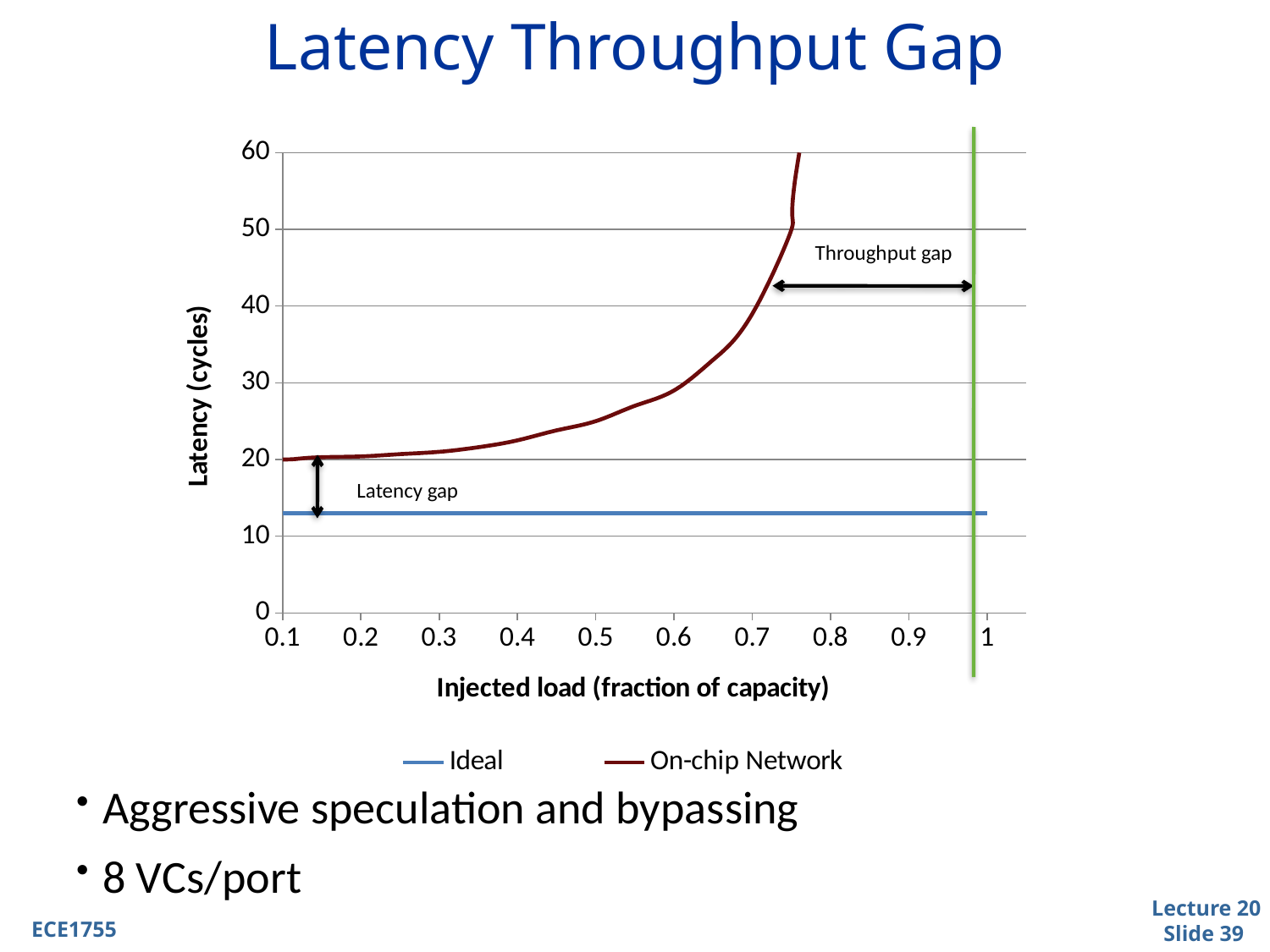
What is the label of the x axis? Injected load (fraction of capacity) Is the Ideal latency greater or less than 20? less Is the On-chip Network latency at an injected load of 0.5 greater or less than 30? less Is the On-chip Network latency at an injected load of 0.5 greater or less than 20? greater Which series has the lower latency across the plotted range of injected load? Ideal What kind of chart is shown on the slide? line chart What is the title of the chart? Latency Throughput Gap Does the On-chip Network latency rise or fall as injected load increases along the x axis? rise How many series does the legend list? 2 At an injected load of 0.6, which series has the higher latency, Ideal or On-chip Network? On-chip Network